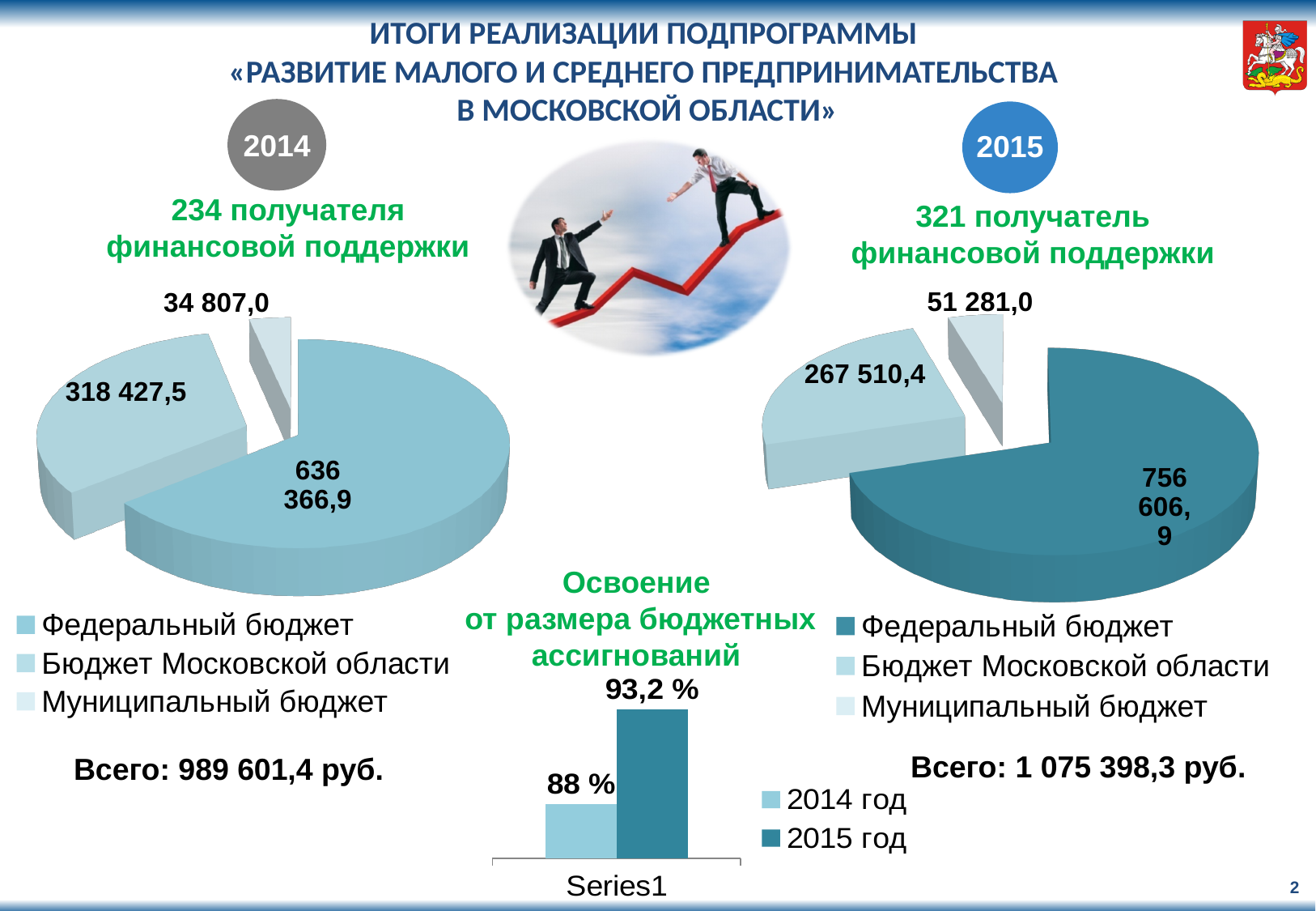
On the bar chart 'Освоение от размера бюджетных ассигнований', what is the value for 2015 год? 93,2 % On the 2015 pie chart, which category has the smallest slice? Муниципальный бюджет On the bar chart 'Освоение от размера бюджетных ассигнований', how many series does the legend list? 2 On the 2015 pie chart, what is the value for Федеральный бюджет? 756 606,9 How many categories does the 2015 pie chart legend list? 3 On the 2014 pie chart, which category has the largest slice? Федеральный бюджет On the 2015 pie chart, what is the value for Бюджет Московской области? 267 510,4 On the bar chart 'Освоение от размера бюджетных ассигнований', what is the value for 2014 год? 88 % On the 2014 pie chart, what is the value for Муниципальный бюджет? 34 807,0 On the 2014 pie chart, what is the difference between Федеральный бюджет and Бюджет Московской области? 317 939,4 On the 2014 pie chart, what is the value for Федеральный бюджет? 636 366,9 Which is larger: Муниципальный бюджет in 2014 or Муниципальный бюджет in 2015? 2015